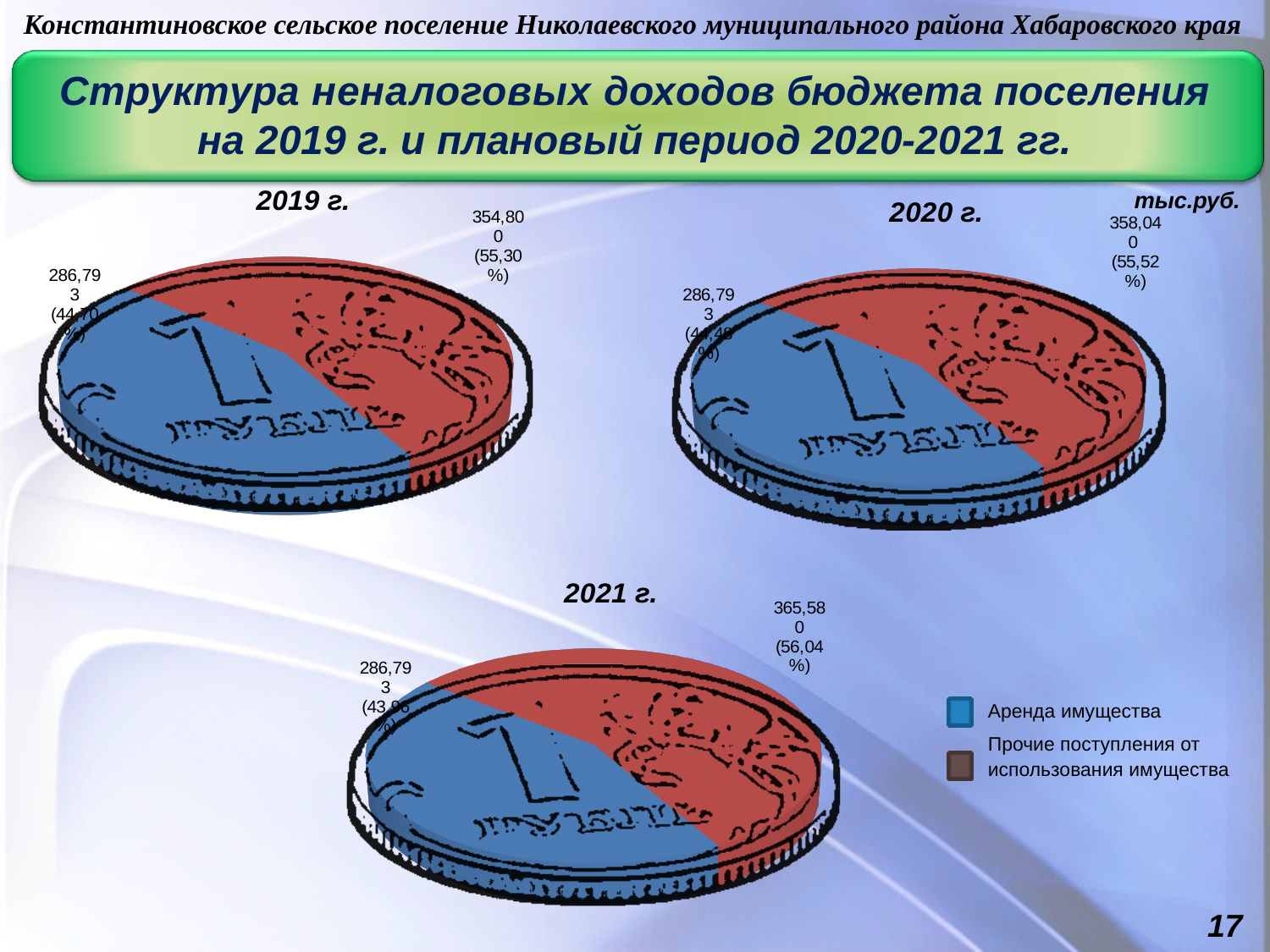
Across the three charts, does the value for Прочие поступления от использования имущества rise or fall from 2019 to 2021? rises In the 2019 chart, what is the value for Прочие поступления от использования имущества? 354,800 What kind of chart is used for each year on this slide? pie chart How many entries does the legend list? 2 In the 2019 chart, what is the value for Аренда имущества? 286,793 In the 2019 chart, what share of the pie does Прочие поступления от использования имущества take? 55,30% In the 2021 chart, what share of the pie does Прочие поступления от использования имущества take? 56,04% In the 2020 chart, what share of the pie does Прочие поступления от использования имущества take? 55,52% In the 2020 chart, what is the value for Прочие поступления от использования имущества? 358,040 In the 2021 chart, which is larger: Аренда имущества or Прочие поступления от использования имущества? Прочие поступления от использования имущества In the 2021 chart, what is the value for Прочие поступления от использования имущества? 365,580 In the 2019 chart, what is the difference between Прочие поступления от использования имущества and Аренда имущества? 68,007